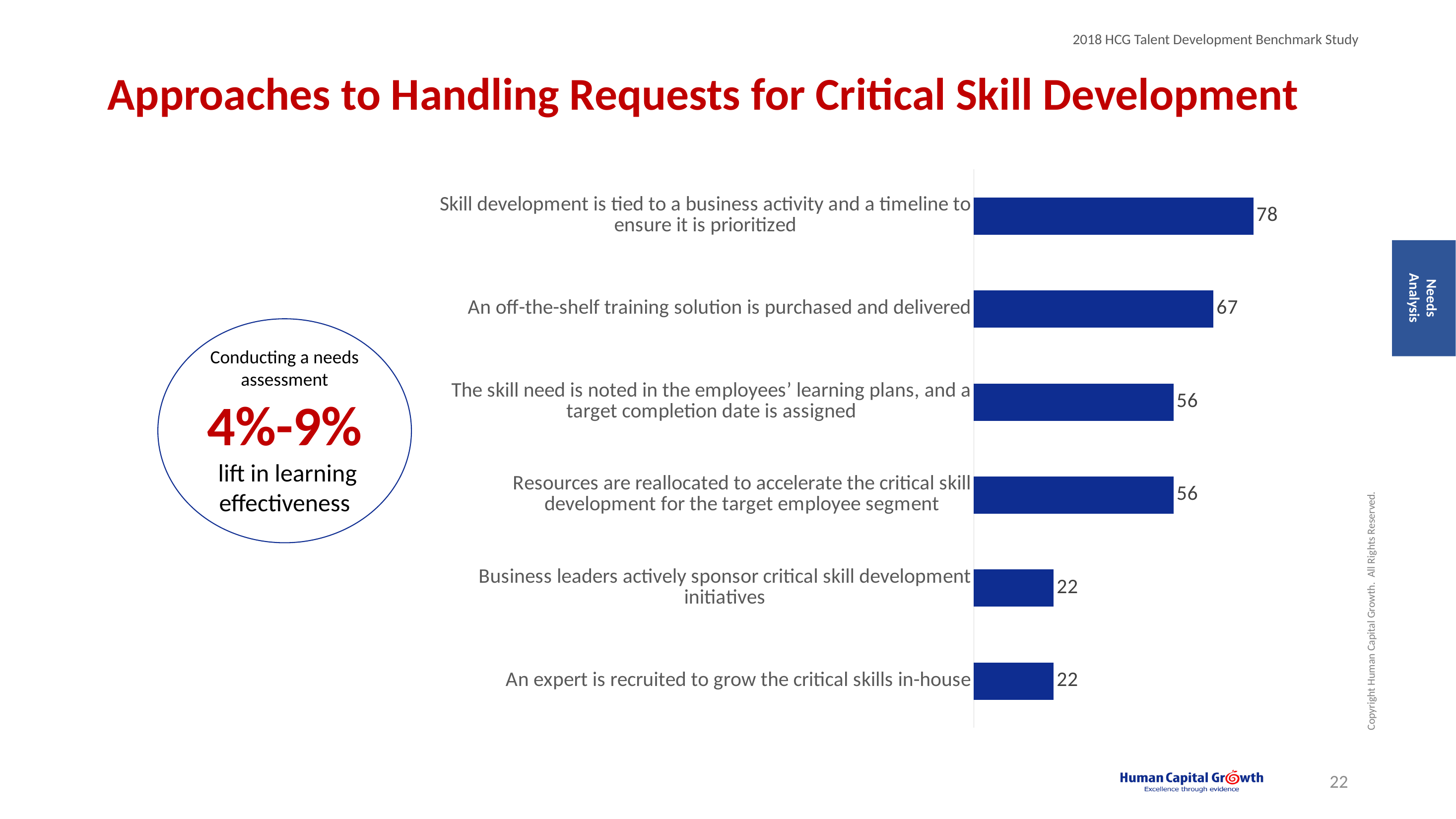
What is the value for 'Skill development is tied to a business activity and a timeline to ensure it is prioritized'? 78 How many approaches (bars) are shown in the chart? 6 What type of chart is shown on the slide? Bar chart What is the difference between the values for 'An off-the-shelf training solution is purchased and delivered' and 'An expert is recruited to grow the critical skills in-house'? 45 How many approaches share the value 22? 2 Which is larger: the value for 'An off-the-shelf training solution is purchased and delivered' or the value for 'The skill need is noted in the employees' learning plans, and a target completion date is assigned'? An off-the-shelf training solution is purchased and delivered What is the value for 'An off-the-shelf training solution is purchased and delivered'? 67 What is the value for 'Resources are reallocated to accelerate the critical skill development for the target employee segment'? 56 What lift in learning effectiveness does the slide attribute to conducting a needs assessment? 4%-9% Which approach has the highest value? Skill development is tied to a business activity and a timeline to ensure it is prioritized What is the value for 'Business leaders actively sponsor critical skill development initiatives'? 22 What is the difference between the values for 'Skill development is tied to a business activity and a timeline to ensure it is prioritized' and 'An off-the-shelf training solution is purchased and delivered'? 11